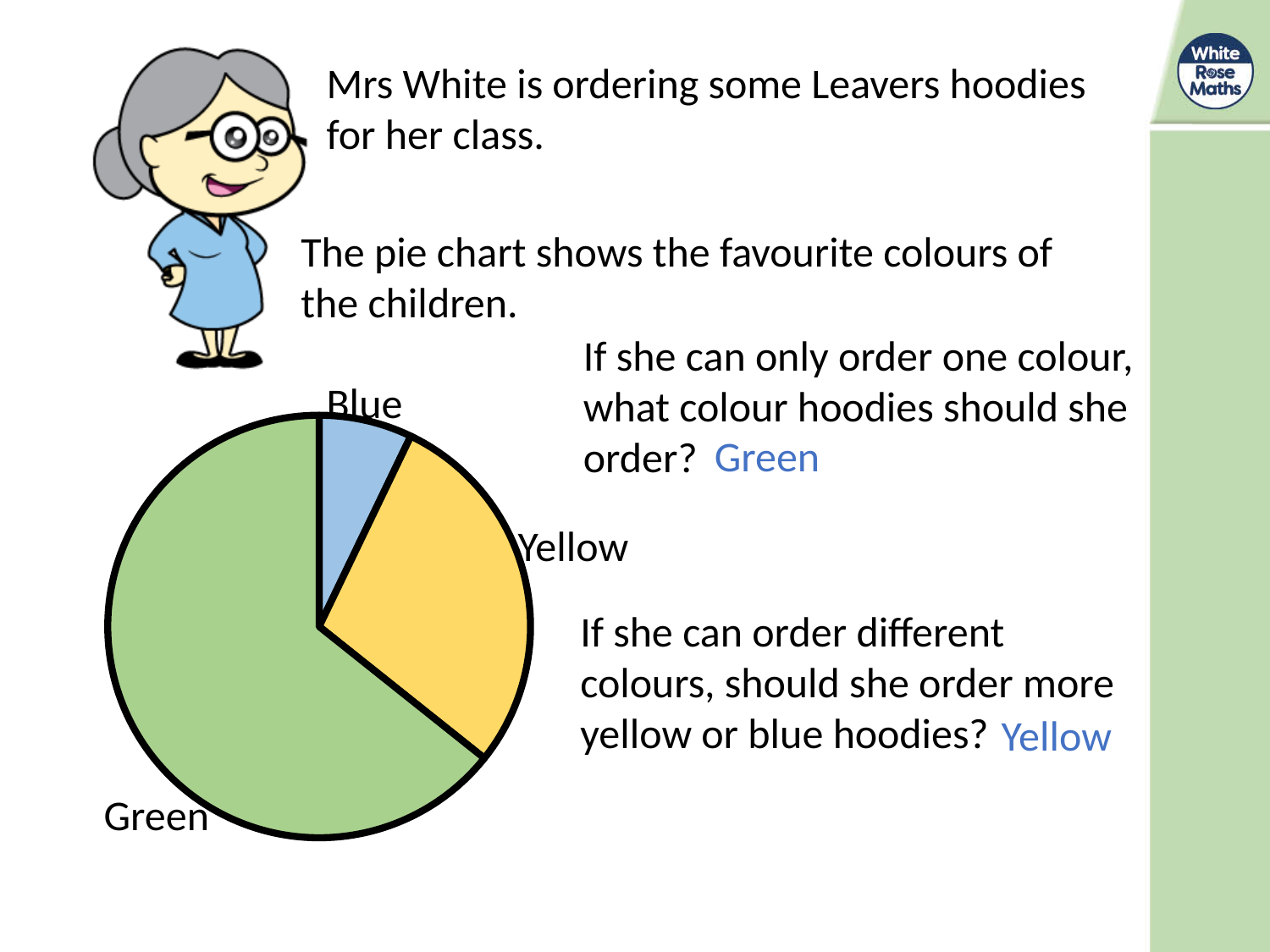
What does the pie chart show, according to the slide? the favourite colours of the children Which slice is larger in the pie chart, Green or Yellow? Green What are the three categories labelled on the pie chart? Blue, Yellow, Green Which colour has the largest slice in the pie chart? Green Does the Green slice take up more or less than half of the pie chart? more What kind of chart is shown on the slide? pie chart Does the Blue slice take up more or less than a quarter of the pie chart? less Which colour has the smallest slice in the pie chart? Blue How many slices does the pie chart have? 3 Which slice is larger in the pie chart, Yellow or Blue? Yellow